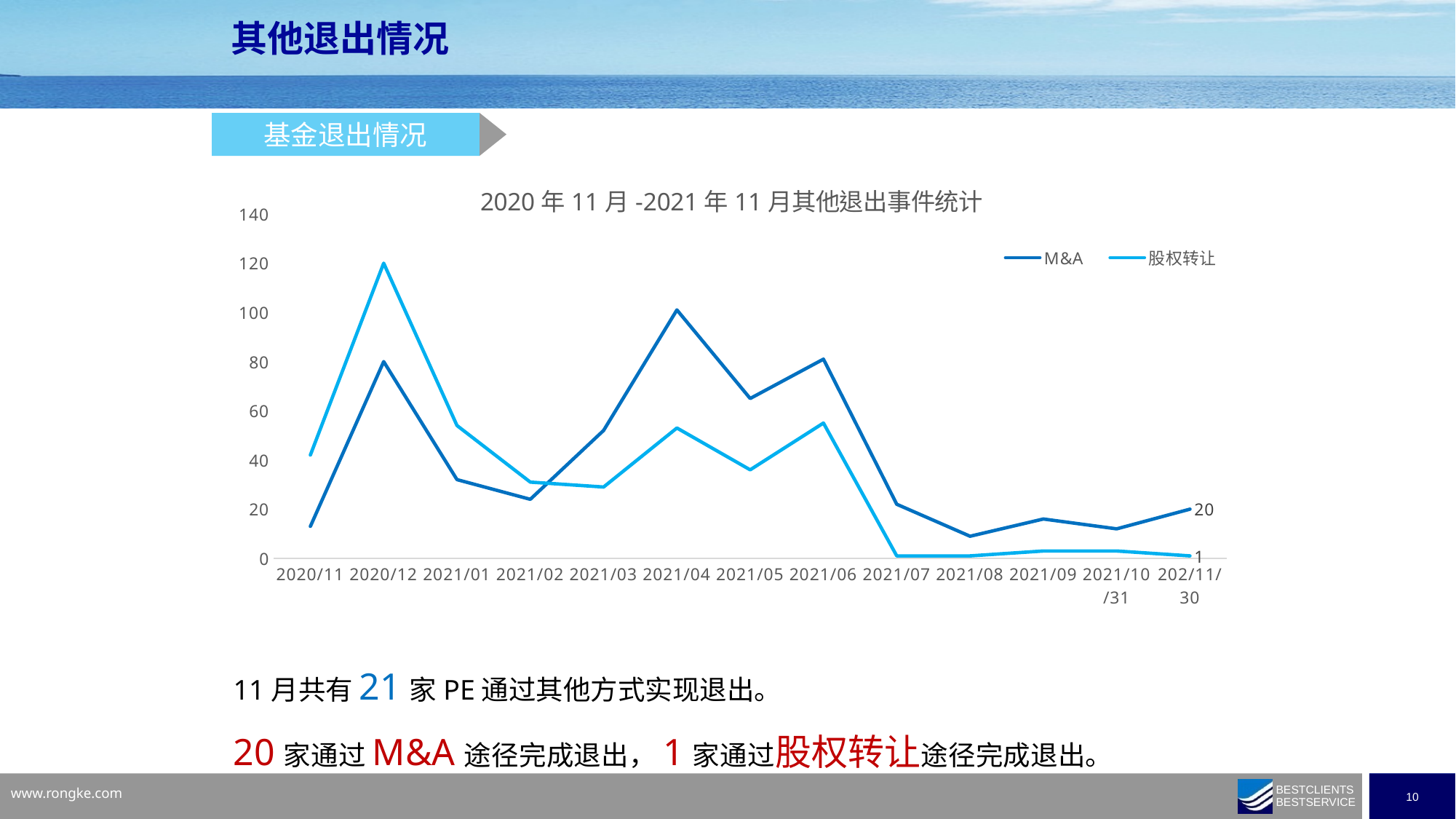
What is the value of the 股权转让 series at 2021/11/30? 1 Is the value for 股权转让 at 2020/12 greater or less than 100? greater At 2020/12, which series has the larger value, M&A or 股权转让? 股权转让 Is the value for M&A at 2020/11 greater or less than 20? less At which month does the M&A series reach its lowest value? 2021/08 How many time points are plotted on the x axis? 13 At 2021/04, which series has the larger value, M&A or 股权转让? M&A At which month does the 股权转让 series reach its highest value? 2020/12 At which month does the M&A series reach its highest value? 2021/04 What is the difference between the M&A value and the 股权转让 value at 2021/11/30? 19 How many series does the legend list? 2 What is the value of the M&A series at 2021/11/30? 20